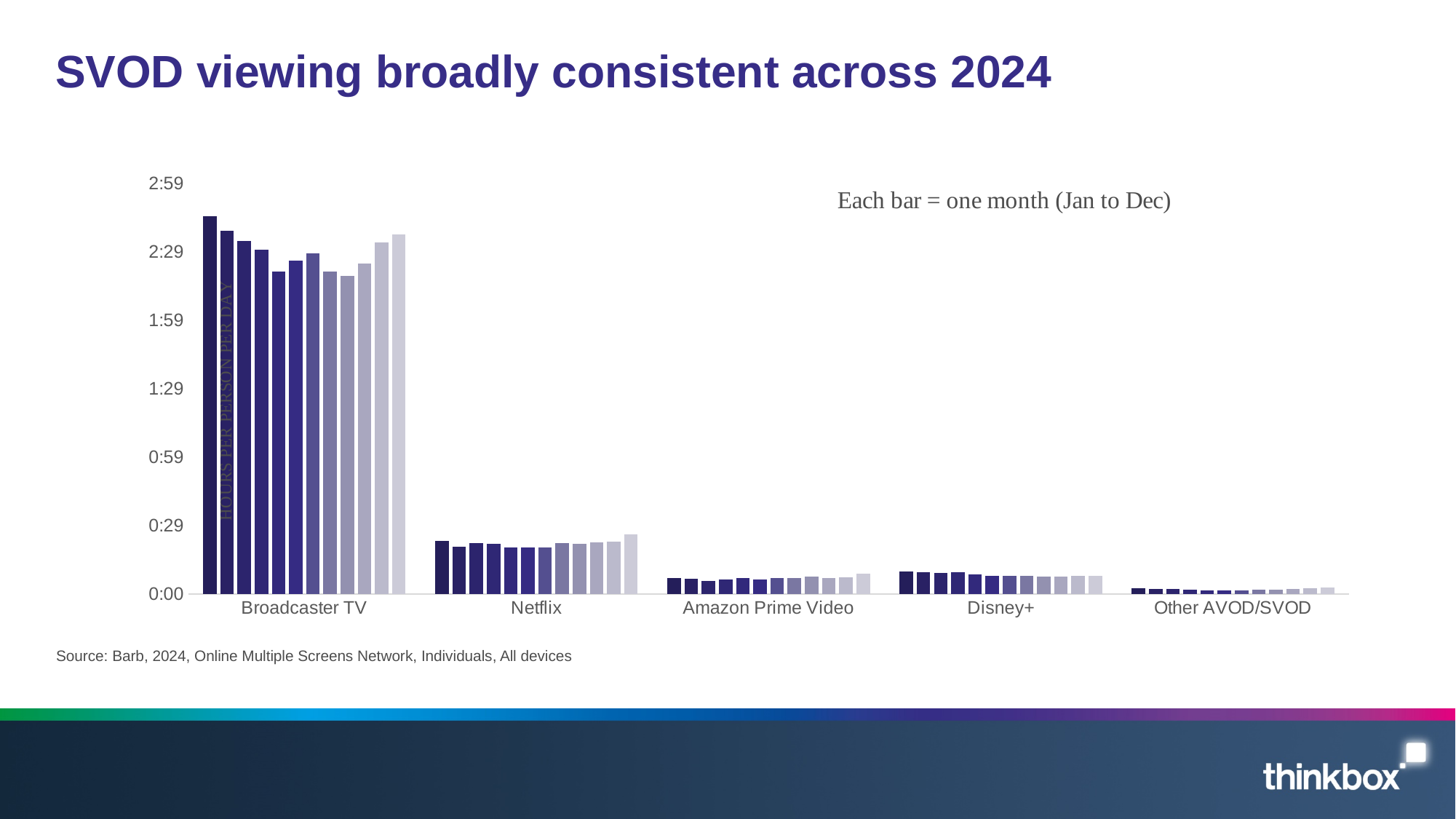
Which has higher viewing hours per person per day, Netflix or Disney+? Netflix Is the value for the first (January) Broadcaster TV bar greater or less than 2:29? greater What is the title of the slide? SVOD viewing broadly consistent across 2024 Which category has the lowest viewing hours per person per day? Other AVOD/SVOD Which has higher viewing hours per person per day, Amazon Prime Video or Other AVOD/SVOD? Amazon Prime Video How many bars are shown for each category? 12 What does each bar in the chart represent, according to the note on the slide? One month (Jan to Dec) Are all the Broadcaster TV bars greater or less than 1:59? greater Which category has the highest viewing hours per person per day? Broadcaster TV Are the Netflix bars greater or less than 0:29? less What kind of chart is shown on the slide? Bar chart How many categories are shown along the x axis of the chart? 5